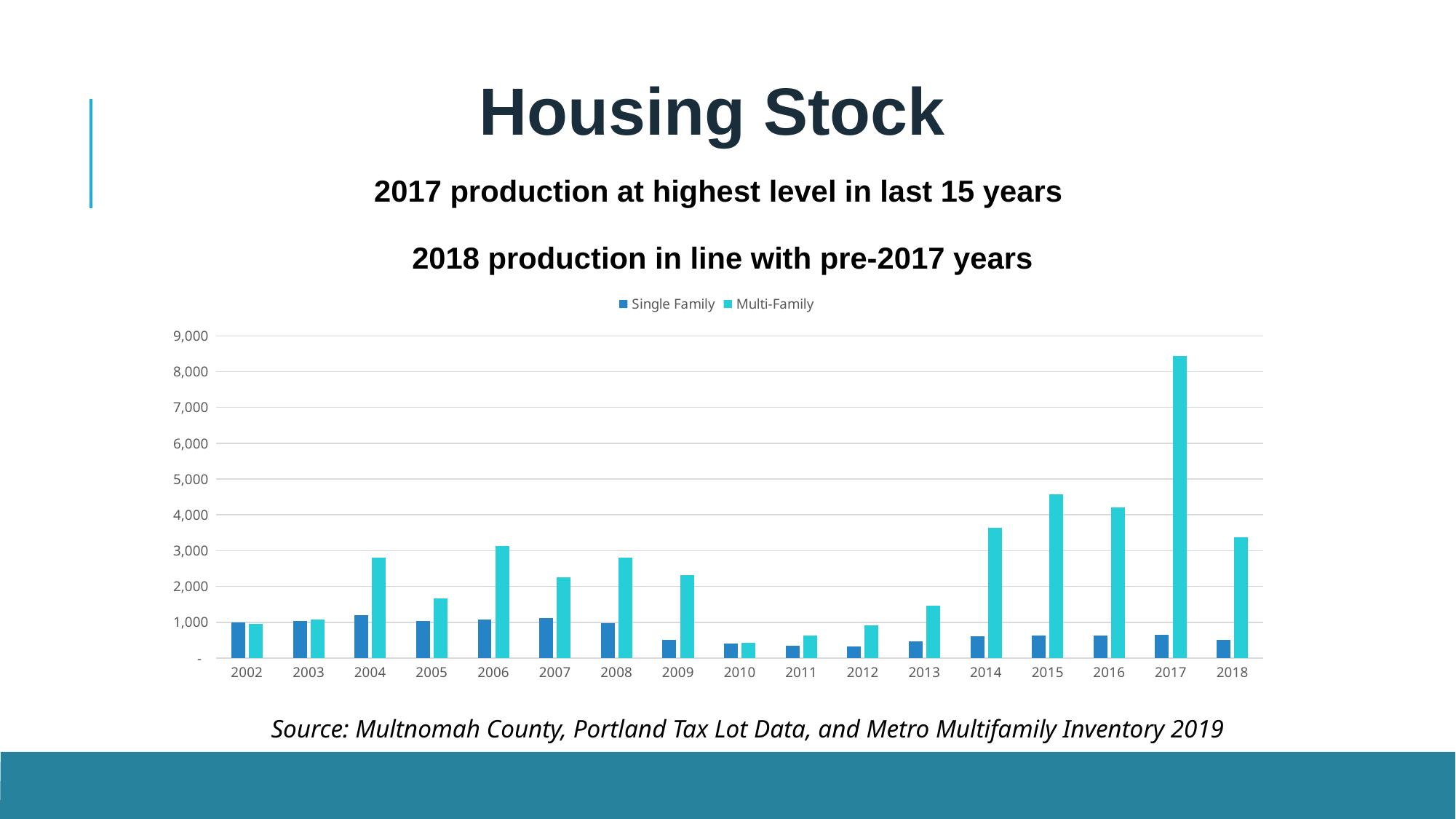
Which is larger, the Multi-Family value for 2014 or for 2013? 2014 Which is larger, the Single Family value for 2004 or for 2012? 2004 Which year has the lowest Multi-Family value? 2010 Is the Multi-Family value for 2017 greater or less than 8,000? greater Do the Multi-Family values rise or fall from 2013 to 2017? rise overall, though 2016 dips slightly below 2015 Is the Single Family value for 2004 greater or less than 1,000? greater Which year has the highest Multi-Family value? 2017 How many series does the legend list? 2 What kind of chart is shown on the slide? bar chart How many years are shown on the x axis? 17 Is the Multi-Family value for 2015 greater or less than 4,000? greater